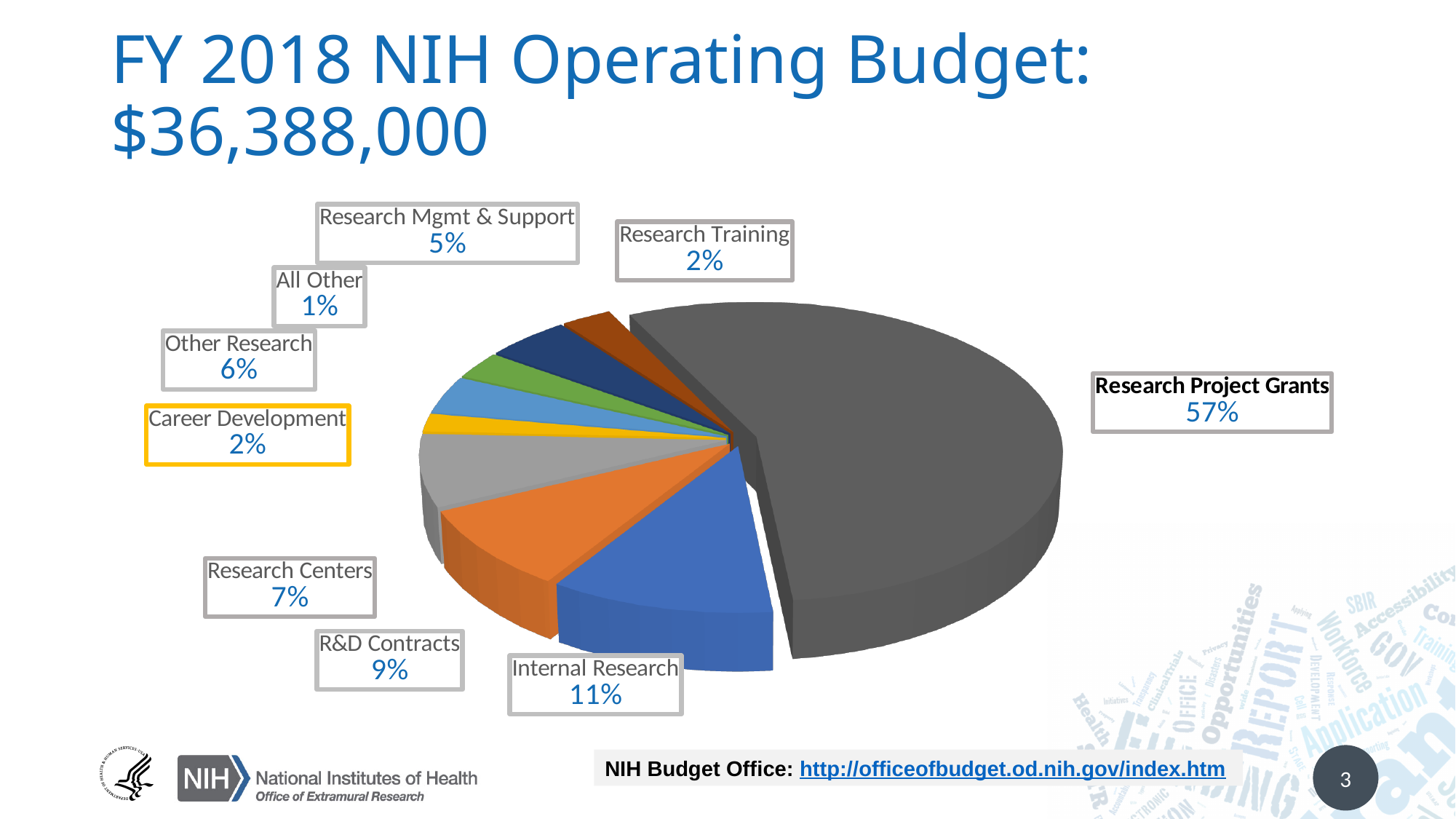
What is the total FY 2018 NIH operating budget stated in the slide title? $36,388,000 Which is larger, the share for Research Centers or the share for Other Research? Research Centers What is the combined share of Research Training and Career Development? 4% What percentage of the budget goes to Research Mgmt & Support? 5% What percentage of the budget is allocated to Internal Research? 11% How many categories are shown in the pie chart? 9 What kind of chart is shown on the slide? pie chart What percentage of the budget is allocated to R&D Contracts? 9% What is the difference in percentage points between Research Project Grants and Internal Research? 46 Which category has the smallest share of the budget? All Other Which category has the largest share of the budget? Research Project Grants What share of the FY 2018 NIH operating budget goes to Research Project Grants? 57%